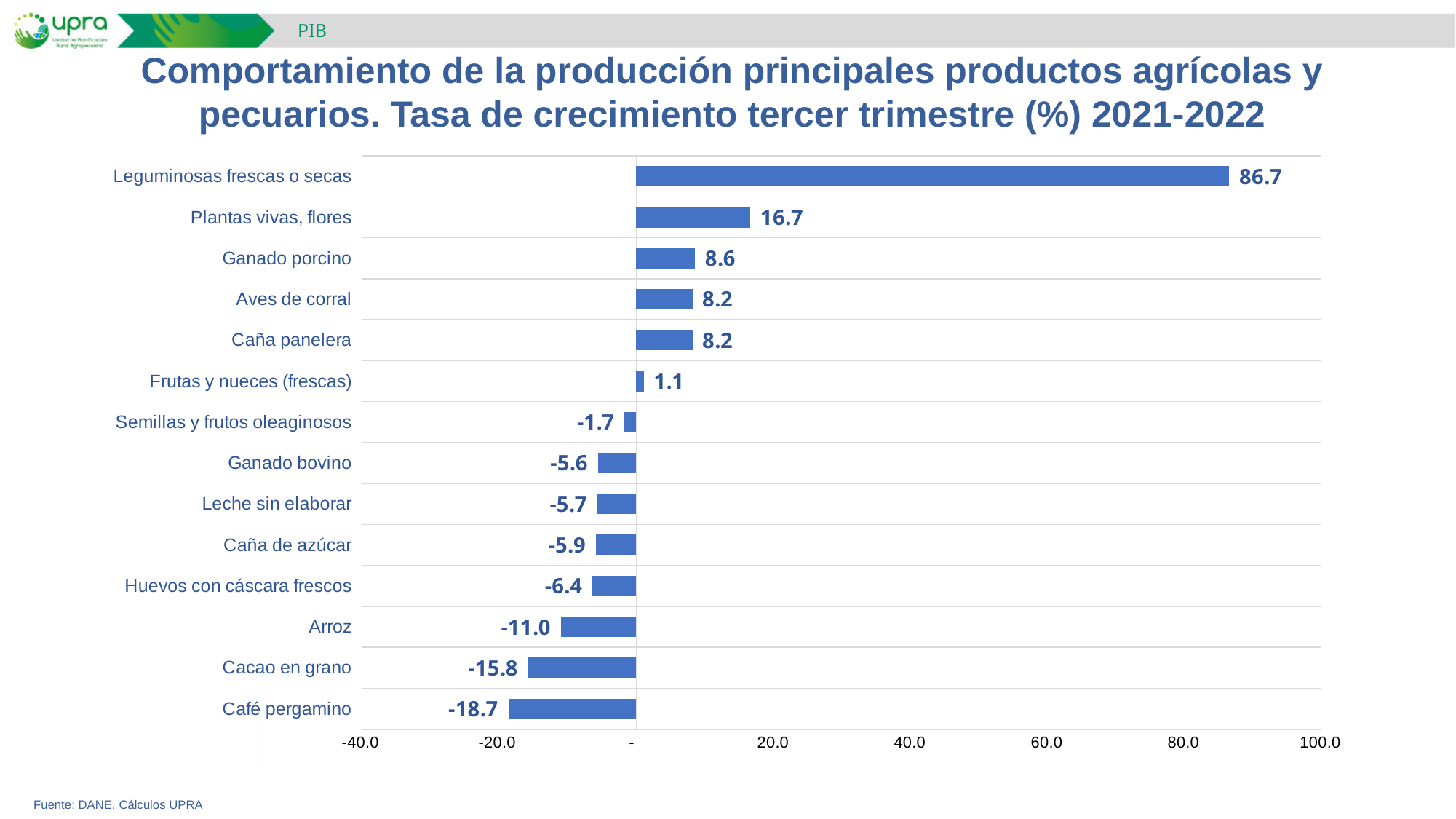
What is the difference between the values for Cacao en grano and Café pergamino? 2.9 What kind of chart is shown on the slide? Bar chart What is the value shown for Ganado porcino? 8.6 What is the difference between the values for Leguminosas frescas o secas and Plantas vivas, flores? 70.0 What is the value shown for Arroz? -11.0 What is the value shown for Café pergamino? -18.7 What source is cited for the chart data? DANE. Cálculos UPRA Which category has the highest growth rate? Leguminosas frescas o secas Which category has the lowest growth rate? Café pergamino Which has a larger value, Ganado porcino or Frutas y nueces (frescas)? Ganado porcino What is the growth rate shown for Leguminosas frescas o secas? 86.7 How many categories are shown in the chart? 14